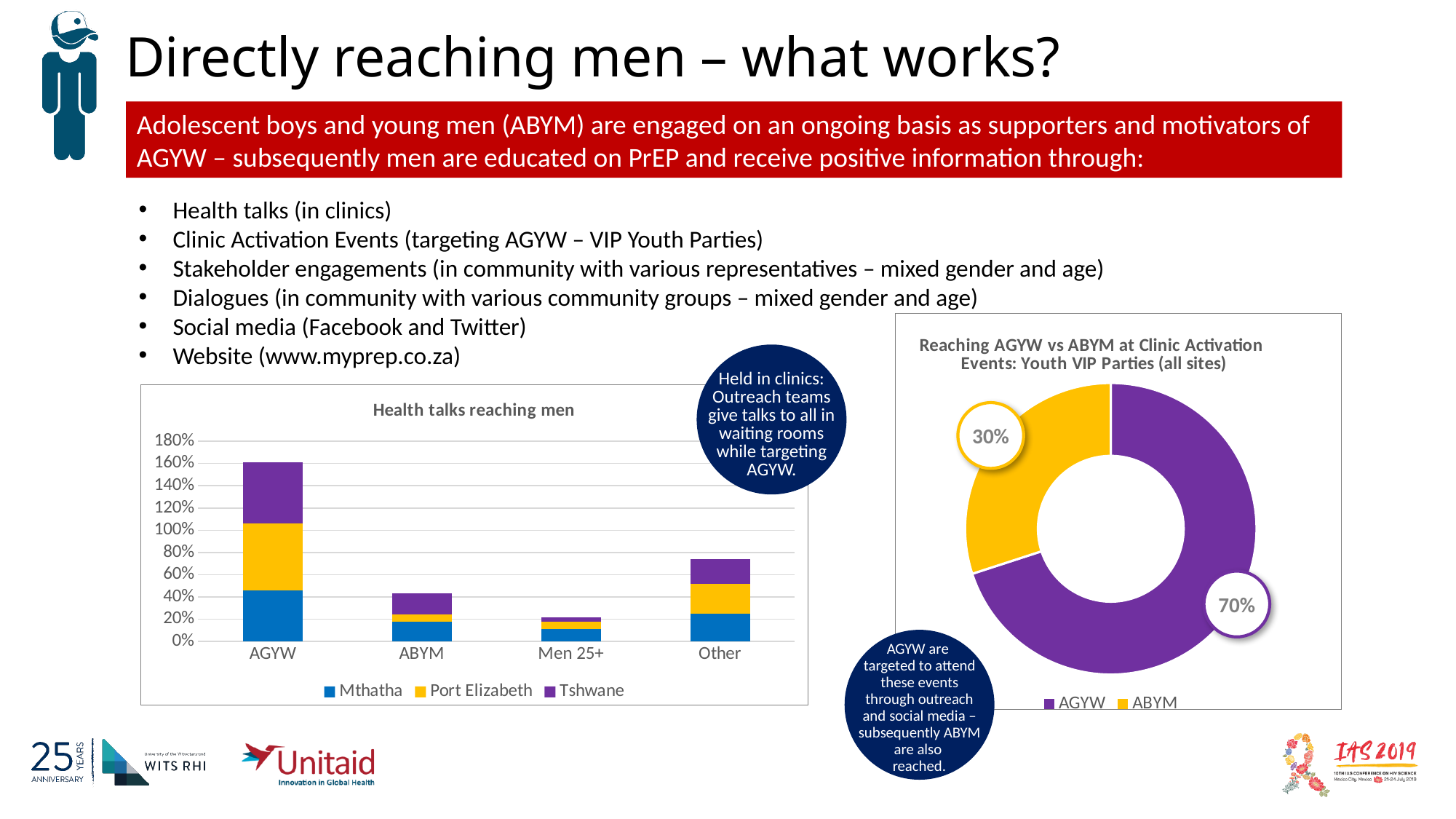
In the 'Reaching AGYW vs ABYM at Clinic Activation Events' chart, what share is AGYW? 70% How many categories are shown on the x axis of the 'Health talks reaching men' chart? 4 What kind of chart is the 'Health talks reaching men' chart? Stacked bar chart In the 'Health talks reaching men' chart, which category has the lowest total stacked bar? Men 25+ In the 'Reaching AGYW vs ABYM at Clinic Activation Events' chart, what share is ABYM? 30% What kind of chart is the 'Reaching AGYW vs ABYM at Clinic Activation Events' chart? Doughnut chart In the 'Health talks reaching men' chart, which series is shown in yellow? Port Elizabeth How many series does the legend of the 'Health talks reaching men' chart list? 3 In the 'Reaching AGYW vs ABYM at Clinic Activation Events' chart, which group has the larger share? AGYW In the 'Health talks reaching men' chart, is the total stacked value for AGYW greater or less than 140%? greater In the 'Health talks reaching men' chart, which category has the highest total stacked bar? AGYW In the 'Reaching AGYW vs ABYM at Clinic Activation Events' chart, what is the difference in percentage points between the AGYW and ABYM shares? 40 percentage points